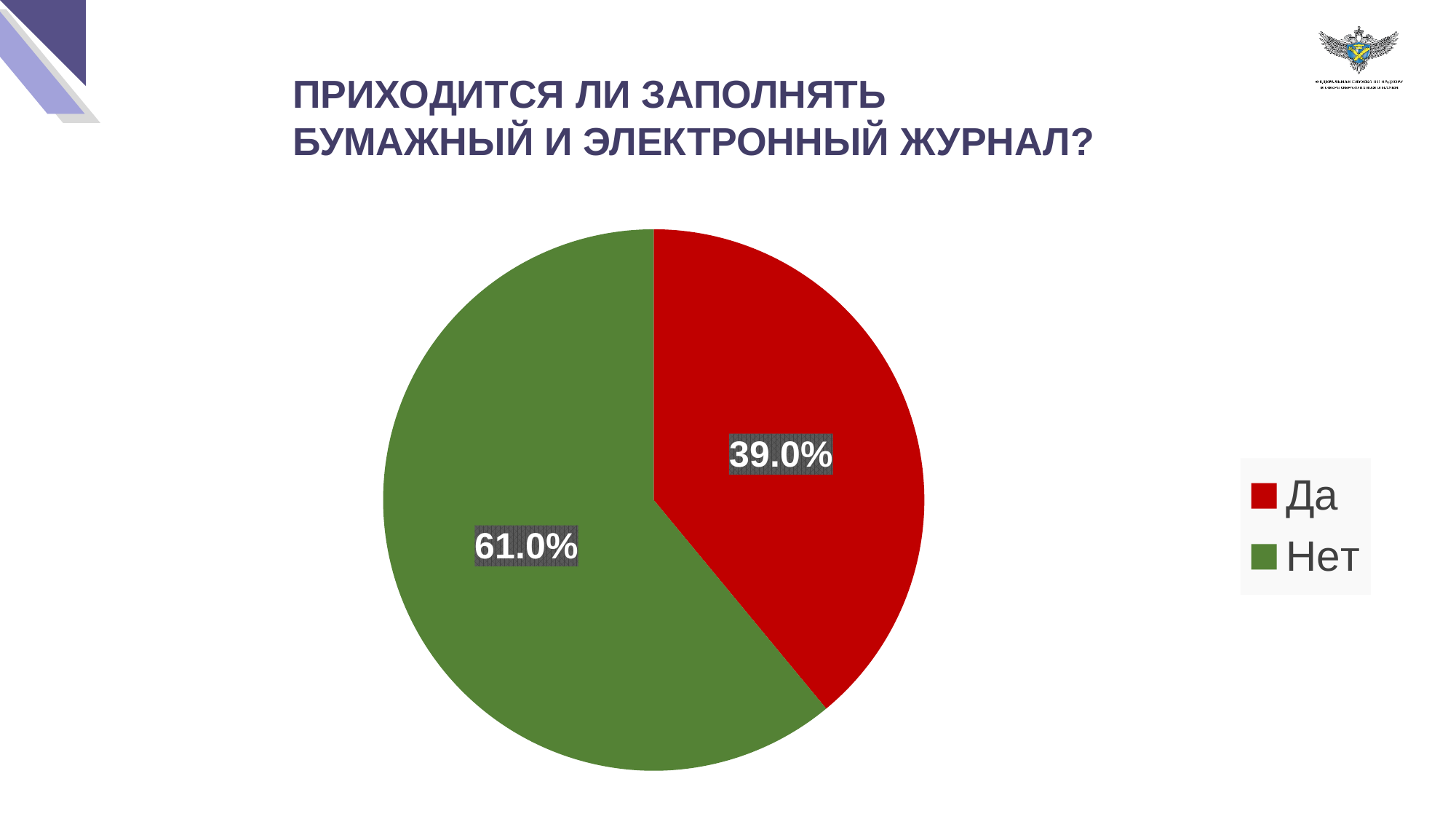
What is the value for "Нет"? 61.0% What share of the pie does the "Да" slice represent? 39.0% What colour is the "Да" slice? red How many slices does the pie chart have? 2 What is the difference between the shares for "Нет" and "Да"? 22.0% Which is larger, the share for "Да" or the share for "Нет"? Нет What kind of chart is shown on the slide? pie chart Which category has the largest share of the pie? Нет Which category has the smallest share of the pie? Да What is the value for "Да"? 39.0% What colour is the "Нет" slice? green How many entries does the legend list? 2